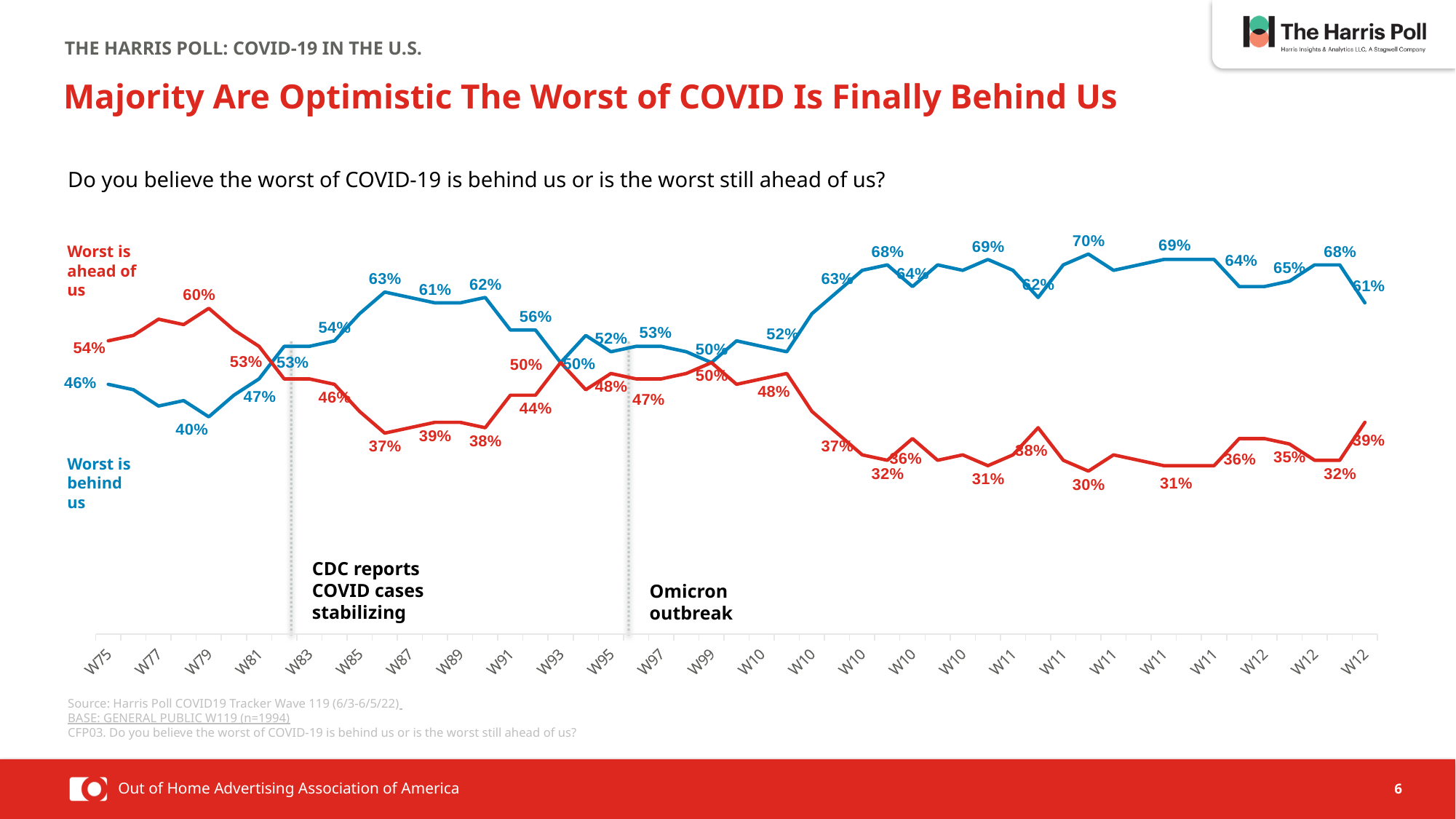
Overall, does the "Worst is behind us" line rise or fall from W75 to the last wave shown? Rise At W75, which series has the larger value, "Worst is ahead of us" or "Worst is behind us"? Worst is ahead of us What is the highest value reached by the "Worst is ahead of us" line? 60% What is the value for "Worst is behind us" at W75? 46% What is the difference between "Worst is ahead of us" and "Worst is behind us" at W75? 8 percentage points What is the value for "Worst is ahead of us" at W75? 54% What colour is the "Worst is behind us" line? Blue What kind of chart is shown on the slide? Line chart What is the highest value reached by the "Worst is behind us" line? 70% How many series does the chart plot? 2 What is the lowest value reached by the "Worst is ahead of us" line? 30% What is the lowest value reached by the "Worst is behind us" line? 40%